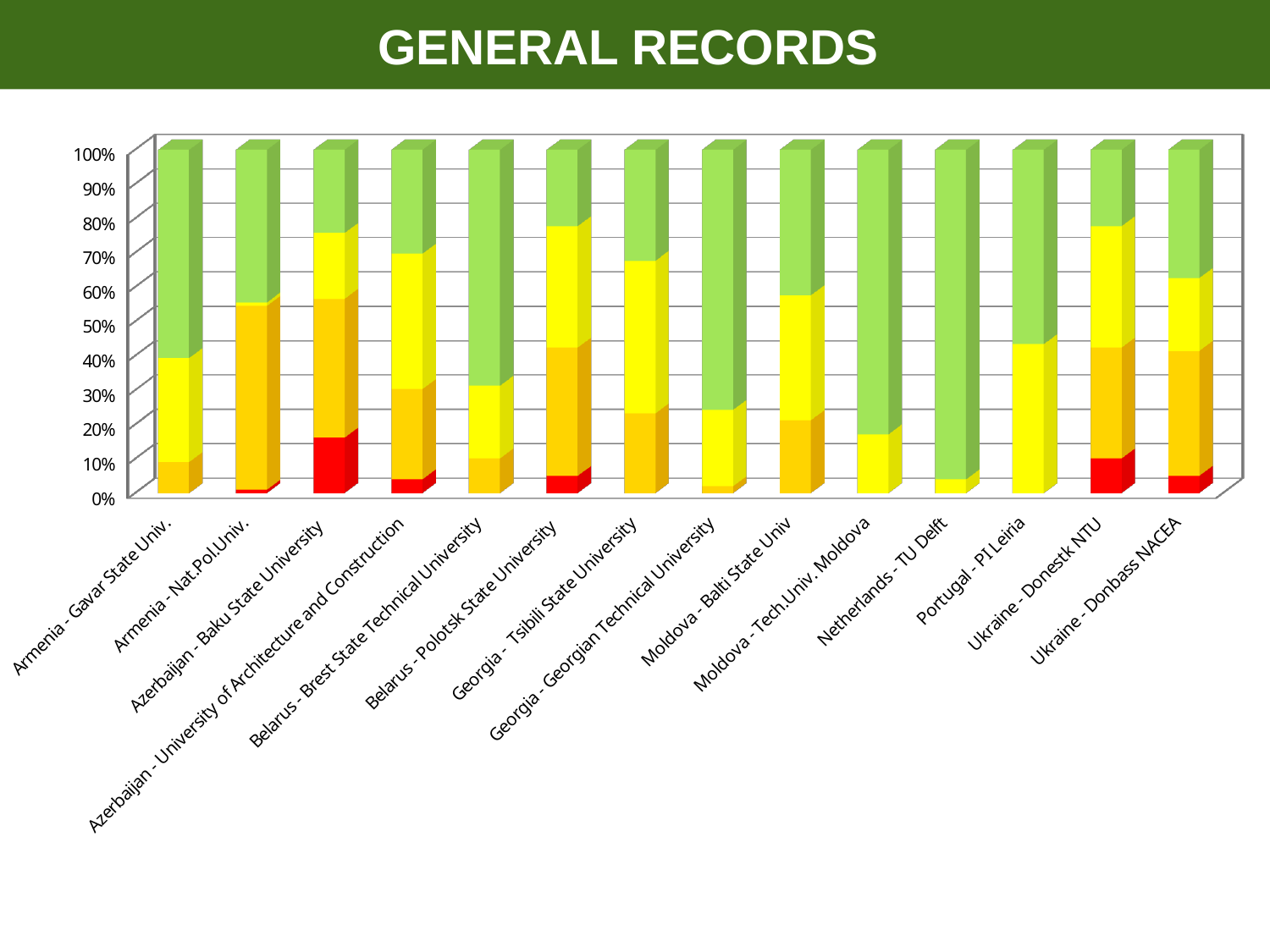
Is the green segment for Armenia - Gavar State Univ. greater or less than 50%? greater Is the green segment larger for Netherlands - TU Delft or for Azerbaijan - Baku State University? Netherlands - TU Delft What is the title of the slide? GENERAL RECORDS What kind of chart is shown on the slide? Stacked bar chart What is the total height of each stacked bar? 100% Which institution has the largest red segment? Azerbaijan - Baku State University Which institution has the largest green segment? Netherlands - TU Delft Is the green segment for Netherlands - TU Delft greater or less than 90%? greater How many institutions (categories) are shown along the x axis? 14 Is the green segment for Georgia - Georgian Technical University greater or less than 60%? greater How many different colours of segments are used in the stacked bars? 4